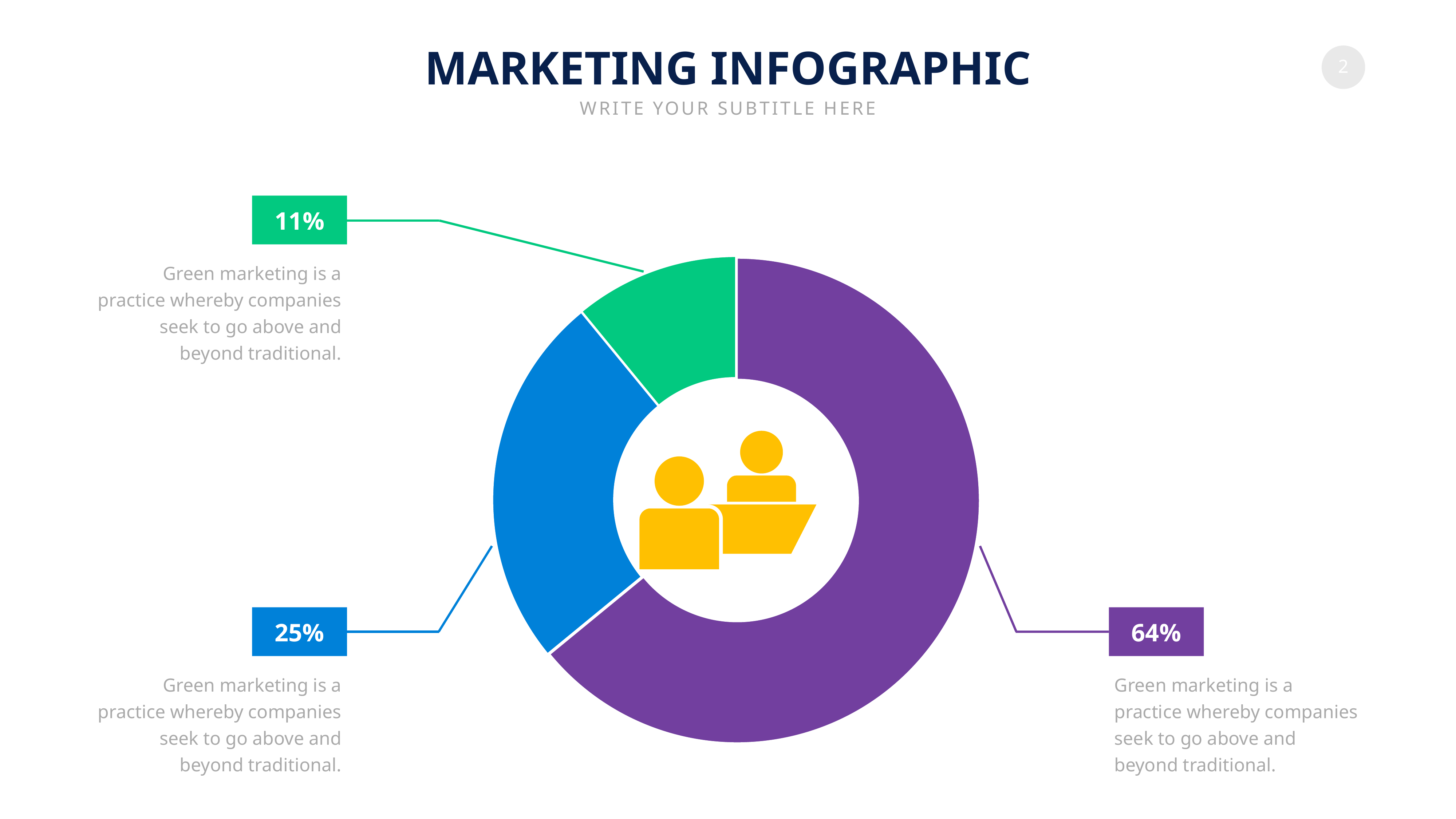
What percentage is shown for the purple segment of the donut chart? 64% What is the combined share of the green and blue segments? 36% What is the difference in percentage points between the blue segment and the green segment? 14 What kind of chart is shown on the slide? Donut chart What is the difference in percentage points between the purple segment and the blue segment? 39 How many segments does the donut chart have? 3 Which is larger, the blue segment or the green segment? The blue segment What percentage is shown for the blue segment of the donut chart? 25% What percentage is shown for the green segment of the donut chart? 11% Which segment of the donut chart has the smallest share? The green segment (11%) Which segment of the donut chart has the largest share? The purple segment (64%) What is the title of the slide containing the donut chart? MARKETING INFOGRAPHIC